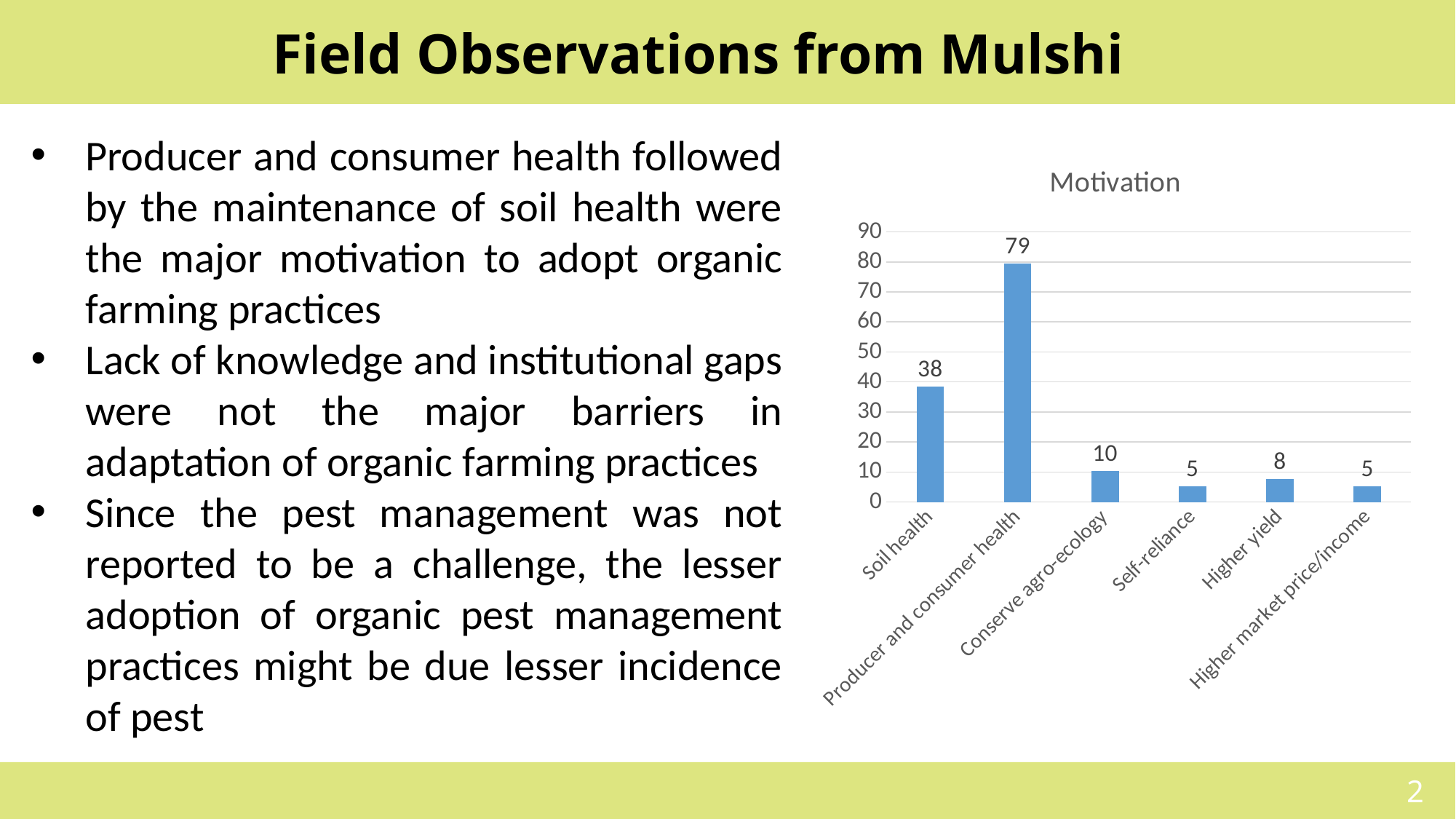
What is the value for Soil health in the Motivation chart? 38 What is the difference between the values for Producer and consumer health and Soil health? 41 Is the value for Soil health greater or less than 30? greater What is the value for Higher yield in the Motivation chart? 8 What is the title of the chart on the slide? Motivation What kind of chart is shown on the slide? Bar chart Which is larger in the Motivation chart, Conserve agro-ecology or Higher yield? Conserve agro-ecology What is the value for Producer and consumer health in the Motivation chart? 79 How many categories are shown in the Motivation chart? 6 Which category has the highest value in the Motivation chart? Producer and consumer health What is the difference between the values for Higher yield and Self-reliance? 3 What is the value for Conserve agro-ecology in the Motivation chart? 10